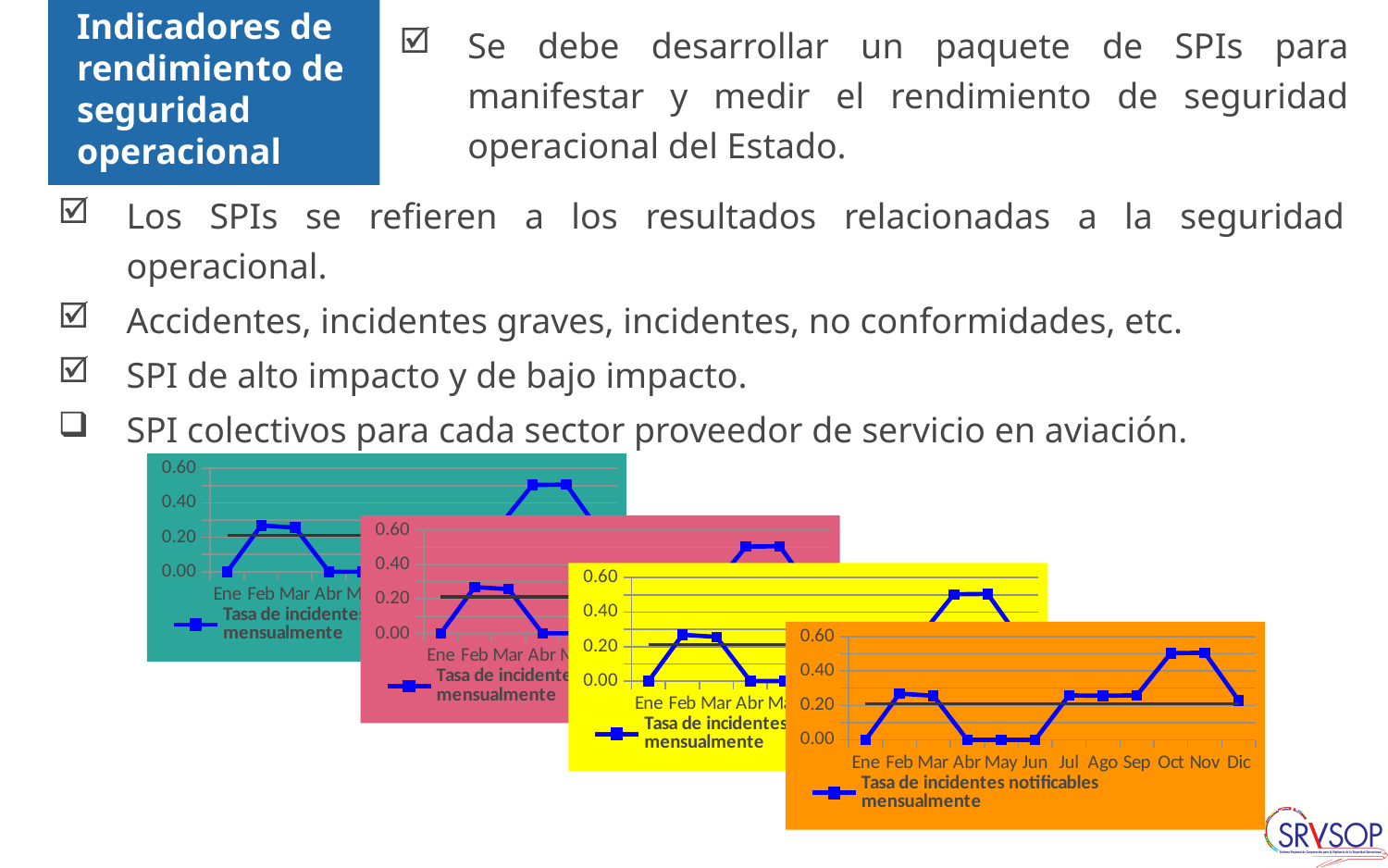
On the front orange chart, what kind of chart is shown? line chart On the front orange chart, which is larger, the value for Oct or the value for Feb? Oct On the front orange chart, is the value for Feb greater or less than 0.20? greater On the front orange chart, which is larger, the value for Jul or the value for Abr? Jul On the front orange chart, is the value for Jul greater or less than 0.40? less On the front orange chart, what is the legend entry for the plotted series? Tasa de incidentes notificables mensualmente On the front orange chart, what is the value for May? 0.00 On the front orange chart, how many months are shown on the x axis? 12 On the front orange chart, how many series does the legend list? 1 On the front orange chart, is the value for Oct greater or less than 0.40? greater On the front orange chart, what is the value for Ene? 0.00 How many charts are shown on the slide? 4